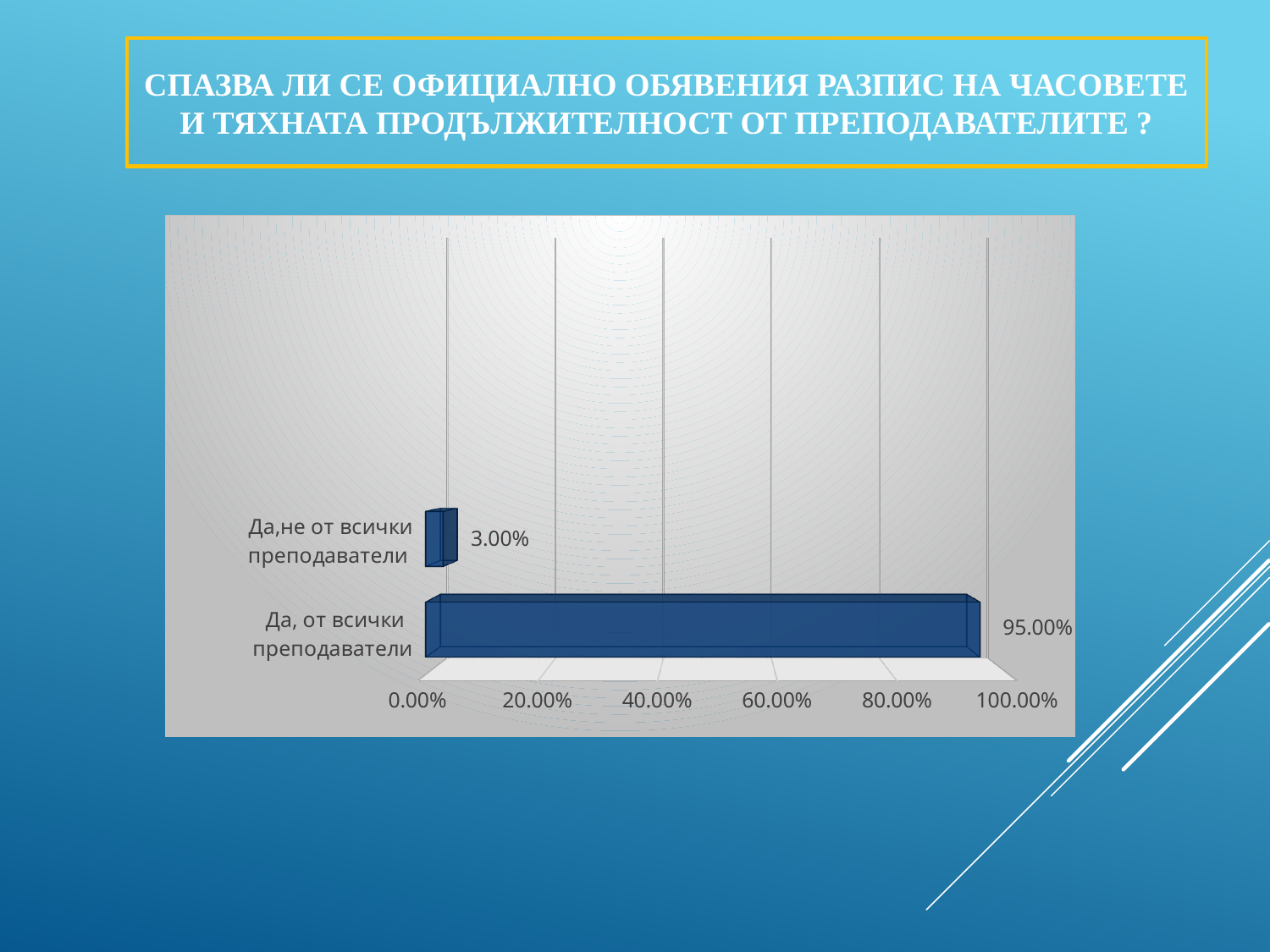
What is the difference between the values for "Да, от всички преподаватели" and "Да,не от всички преподаватели"? 92.00% Which category has the highest value? Да, от всички преподаватели What is the value for "Да,не от всички преподаватели"? 3.00% What is the maximum value shown on the horizontal axis? 100.00% Is the value for "Да,не от всички преподаватели" greater or less than 20.00%? less What is the value for "Да, от всички преподаватели"? 95.00% Are the bars in the chart horizontal or vertical? horizontal Which category has the lowest value? Да,не от всички преподаватели What kind of chart is shown on the slide? bar chart Which is larger: the value for "Да, от всички преподаватели" or for "Да,не от всички преподаватели"? Да, от всички преподаватели Is the value for "Да, от всички преподаватели" greater or less than 80.00%? greater How many categories are shown in the chart? 2